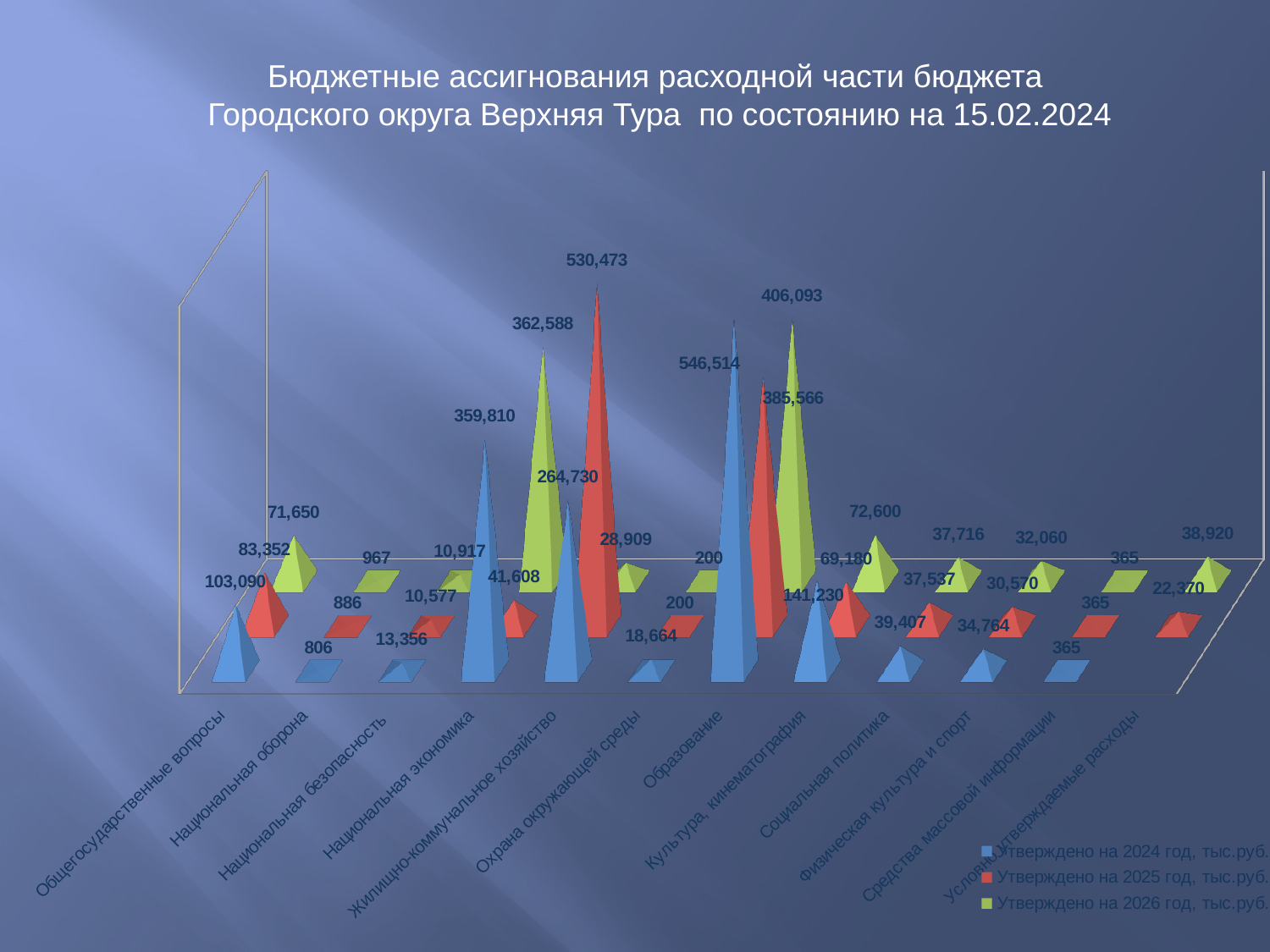
How many series does the legend list? 3 Which category has the highest value in the series Утверждено на 2024 год? Образование What is the value for Национальная оборона in the series Утверждено на 2024 год? 806 What is the value for Жилищно-коммунальное хозяйство in the series Утверждено на 2025 год? 530,473 In the series Утверждено на 2024 год, which is larger: Национальная экономика or Жилищно-коммунальное хозяйство? Национальная экономика What kind of chart is shown on the slide? bar chart What is the value for Образование in the series Утверждено на 2024 год? 546,514 Which colour represents the series Утверждено на 2026 год? green What is the value for Национальная экономика in the series Утверждено на 2026 год? 362,588 Which category has the highest value in the series Утверждено на 2025 год? Жилищно-коммунальное хозяйство How many categories are shown along the x axis? 12 What is the difference between the 2024 and 2025 values for Образование? 160,948